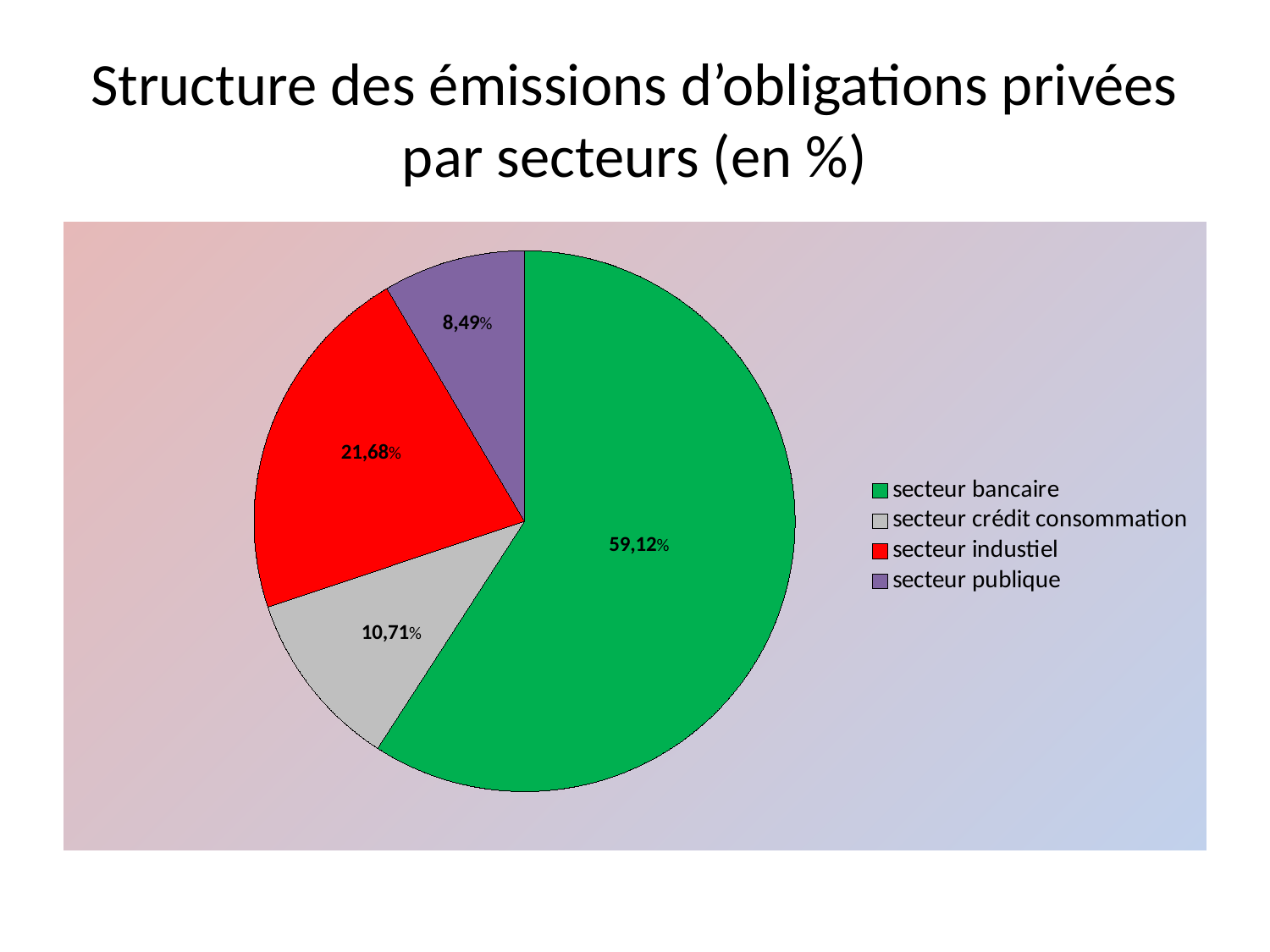
What is the value for secteur industiel? 21,68% What is the difference between the values for secteur bancaire and secteur industiel? 37,44% What is the value for secteur crédit consommation? 10,71% What is the value for secteur bancaire? 59,12% What is the value for secteur publique? 8,49% Which sector has the largest share of the pie? secteur bancaire What kind of chart is shown on the slide? pie chart Which sector has the smallest share of the pie? secteur publique What colour is the slice for secteur industiel? red How many slices does the pie chart have? 4 Which is larger, secteur industiel or secteur crédit consommation? secteur industiel What is the title of the slide? Structure des émissions d'obligations privées par secteurs (en %)